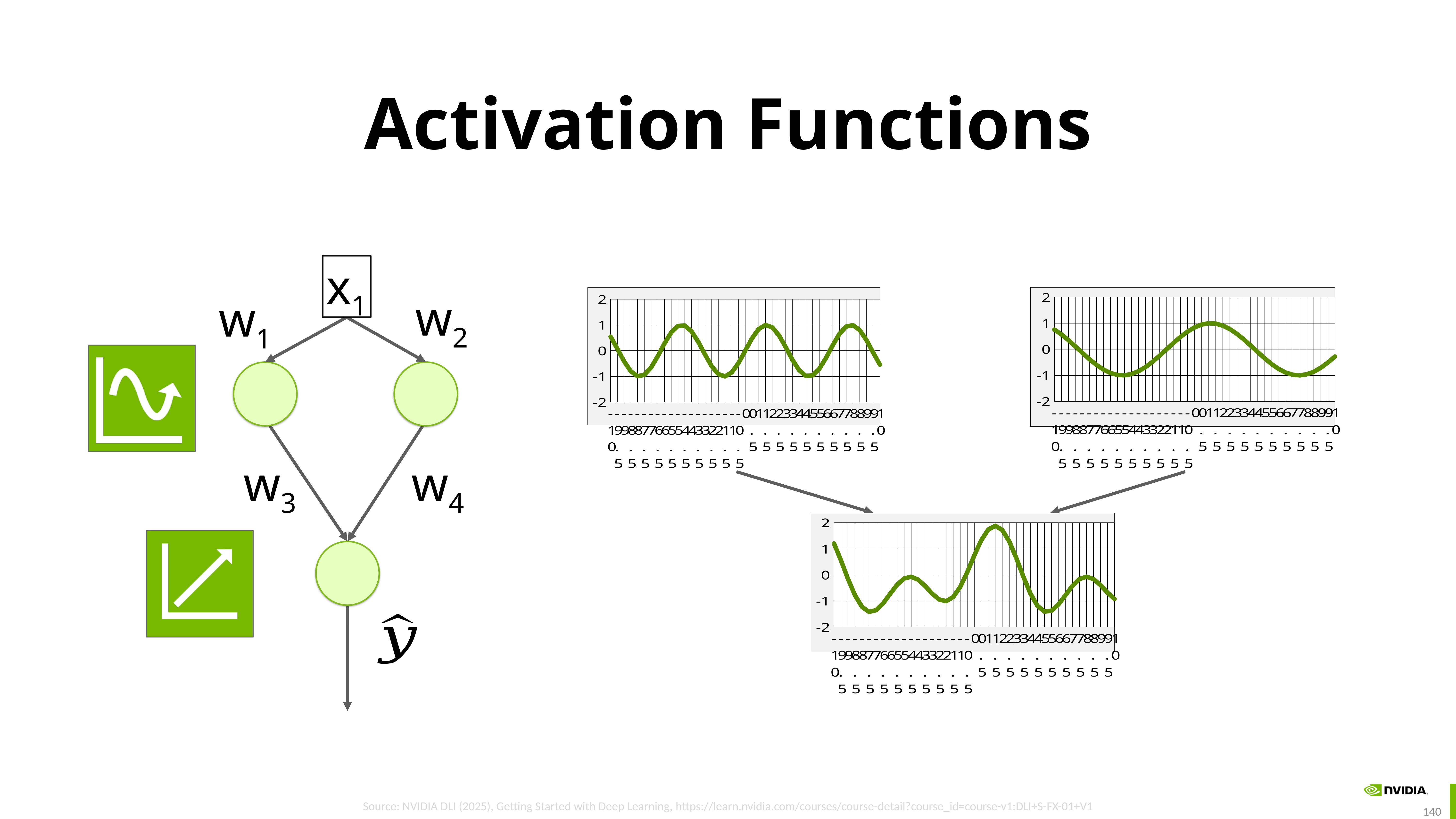
On the bottom chart, is the highest point of the line greater or less than 1? greater How many peaks does the line in the top-left chart have? 3 On the bottom chart, what is the highest value shown on the y axis? 2 On the top-right chart, is the lowest point of the line greater or less than -2? greater What kind of chart is the top-left chart on the slide? line chart How many peaks does the line in the top-right chart have? 1 How many charts are shown on the slide? 3 On the top-right chart, does the line rise or fall at the start of the x axis? fall On the top-left chart, is the highest point of the line greater or less than 2? less Which chart reaches a higher maximum value, the top-left chart or the bottom chart? the bottom chart